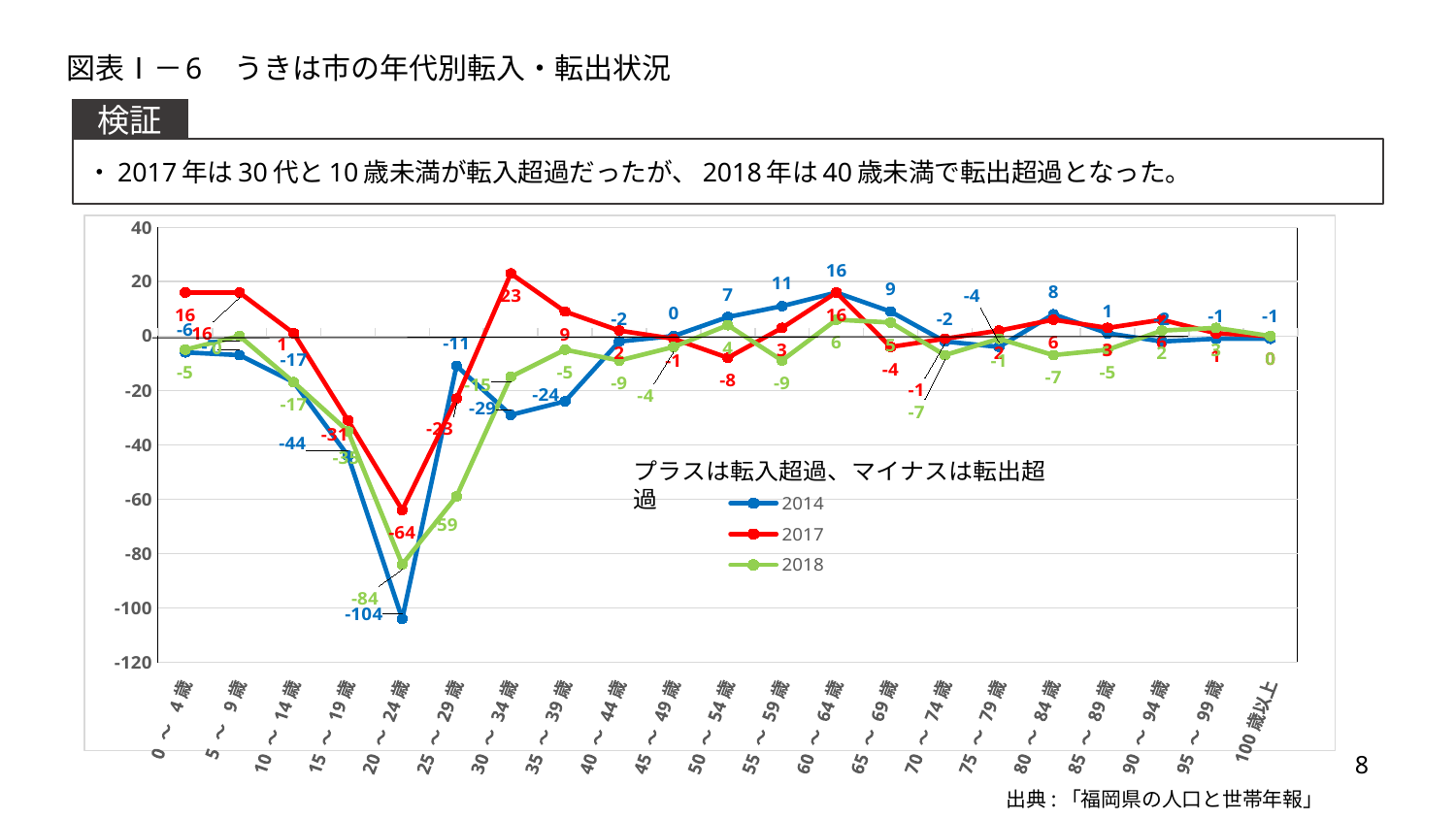
What is the 2014 value for 20～24歳? -104 How many series does the legend list? 3 What is the 2017 value for 20～24歳? -64 Which age category has the highest value for the 2017 series? 30～34歳 Which age category has the lowest value for the 2014 series? 20～24歳 How many age categories are plotted along the x axis? 21 What is the 2018 value for 20～24歳? -84 What is the 2017 value for 30～34歳? 23 For 20～24歳, which is larger, the 2017 value or the 2018 value? 2017 Which years are listed in the legend? 2014, 2017, 2018 What is the difference between the 2017 and 2014 values for 20～24歳? 40 What kind of chart is shown on the slide? line chart